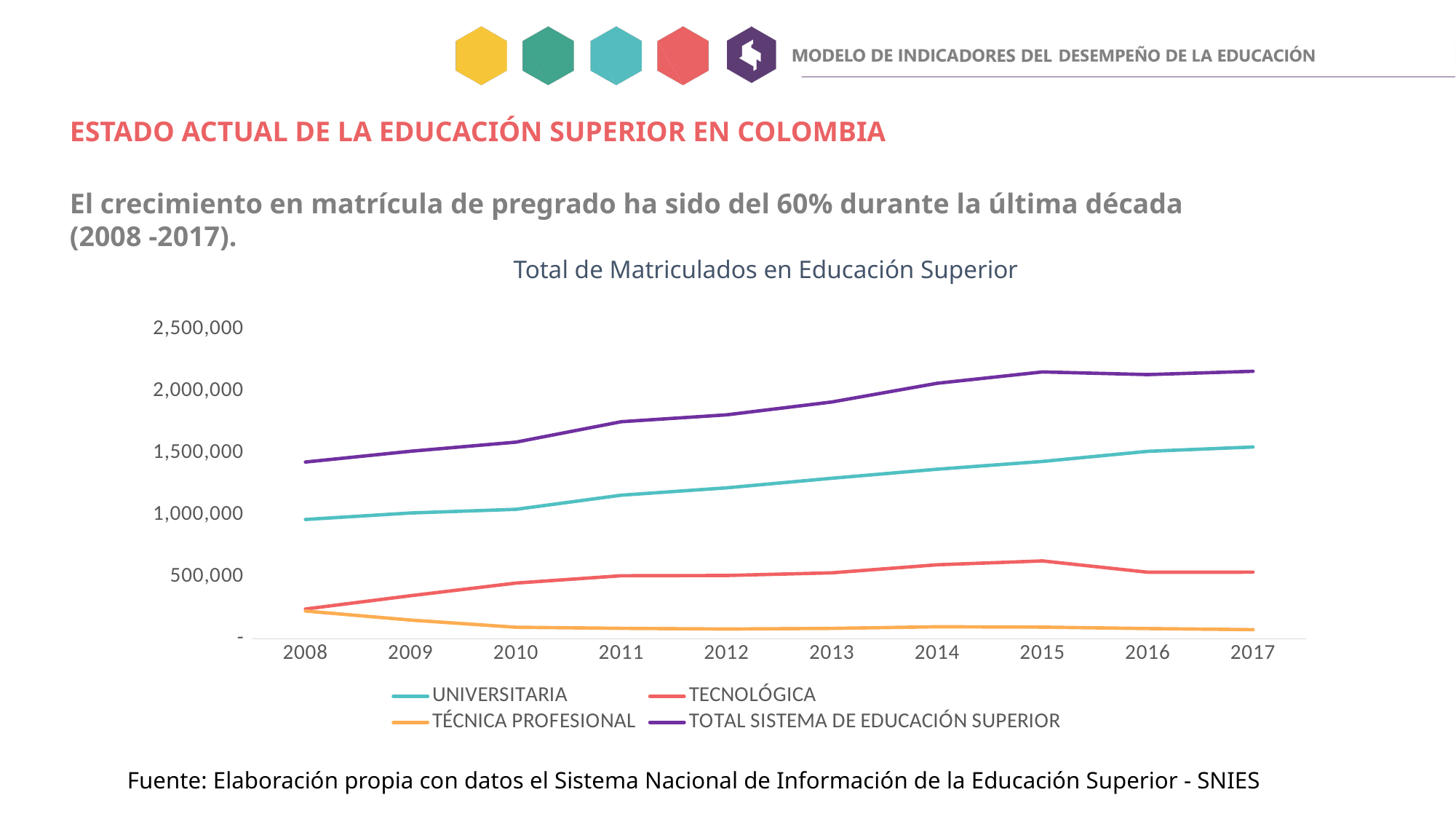
In which year does the TECNOLÓGICA series reach its highest value? 2015 What kind of chart is shown on the slide? line chart Does the UNIVERSITARIA series rise or fall from 2008 to 2017? rise Is the value for TOTAL SISTEMA DE EDUCACIÓN SUPERIOR in 2017 greater or less than 2,000,000? greater What is the title of the chart? Total de Matriculados en Educación Superior How many years are shown on the x axis of the chart? 10 How many series does the legend of the chart list? 4 Does the TÉCNICA PROFESIONAL series rise or fall from 2008 to 2017? fall Is the value for TOTAL SISTEMA DE EDUCACIÓN SUPERIOR in 2008 greater or less than 1,500,000? less In 2012, which is larger: UNIVERSITARIA or TECNOLÓGICA? UNIVERSITARIA Which series has the lowest value in 2017? TÉCNICA PROFESIONAL Is the value for TÉCNICA PROFESIONAL in 2017 greater or less than 500,000? less